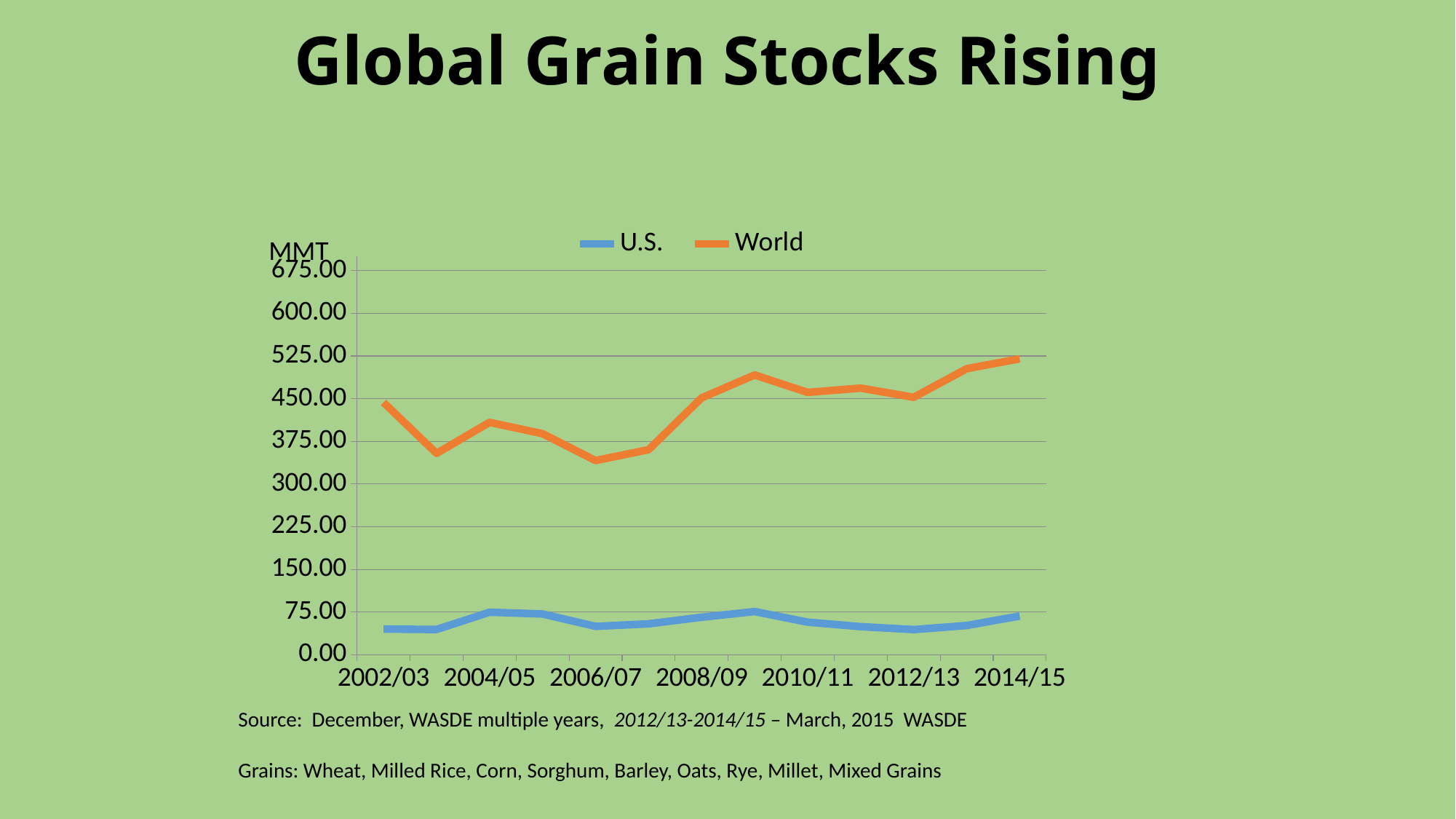
What is the title of the slide's chart? Global Grain Stocks Rising Which series has the larger value in 2010/11, U.S. or World? World How many series does the legend list? 2 Is the World value for 2002/03 greater or less than 375.00? greater Is the World value for 2006/07 greater or less than 375.00? less Does the World line rise or fall from 2012/13 to 2014/15? rise Which is larger, the World value for 2014/15 or the World value for 2002/03? 2014/15 How many year labels are shown along the x axis? 7 What kind of chart is shown on the slide? line chart Which year has the highest World value? 2014/15 What unit is shown at the top of the y axis? MMT